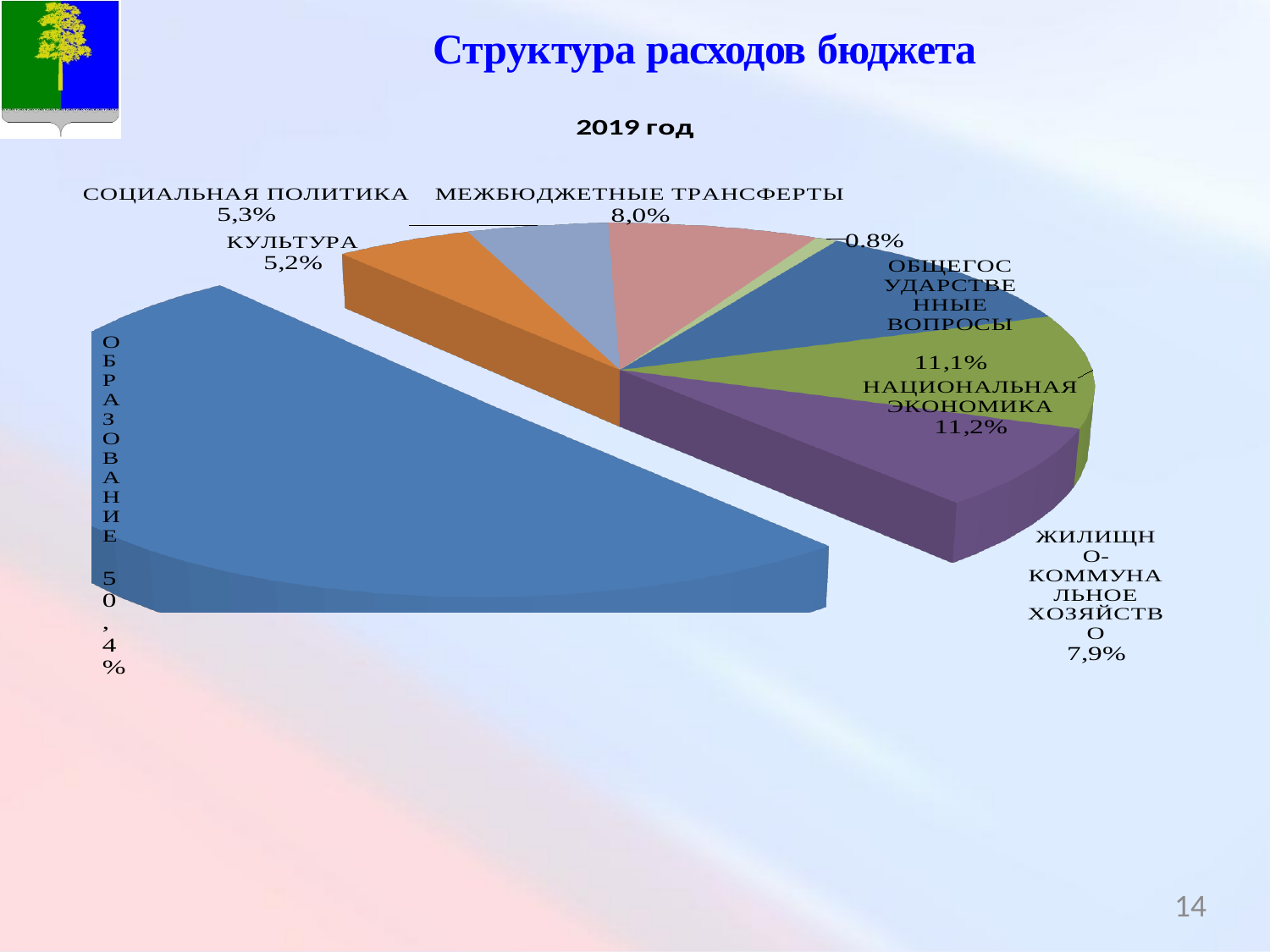
What share of budget expenditure goes to ОБРАЗОВАНИЕ? 50,4% What share is shown for ОБЩЕГОСУДАРСТВЕННЫЕ ВОПРОСЫ? 11,1% What share is shown for ЖИЛИЩНО-КОММУНАЛЬНОЕ ХОЗЯЙСТВО? 7,9% What share is shown for МЕЖБЮДЖЕТНЫЕ ТРАНСФЕРТЫ? 8,0% What kind of chart is shown on the slide? pie chart Which category has the largest share of budget expenditure? ОБРАЗОВАНИЕ Which is larger, the share for СОЦИАЛЬНАЯ ПОЛИТИКА or for КУЛЬТУРА? СОЦИАЛЬНАЯ ПОЛИТИКА How many slices does the pie chart have? 8 What share is shown for КУЛЬТУРА? 5,2% What is the title of the chart? 2019 год Which year does the chart refer to? 2019 год What share is shown for НАЦИОНАЛЬНАЯ ЭКОНОМИКА? 11,2%